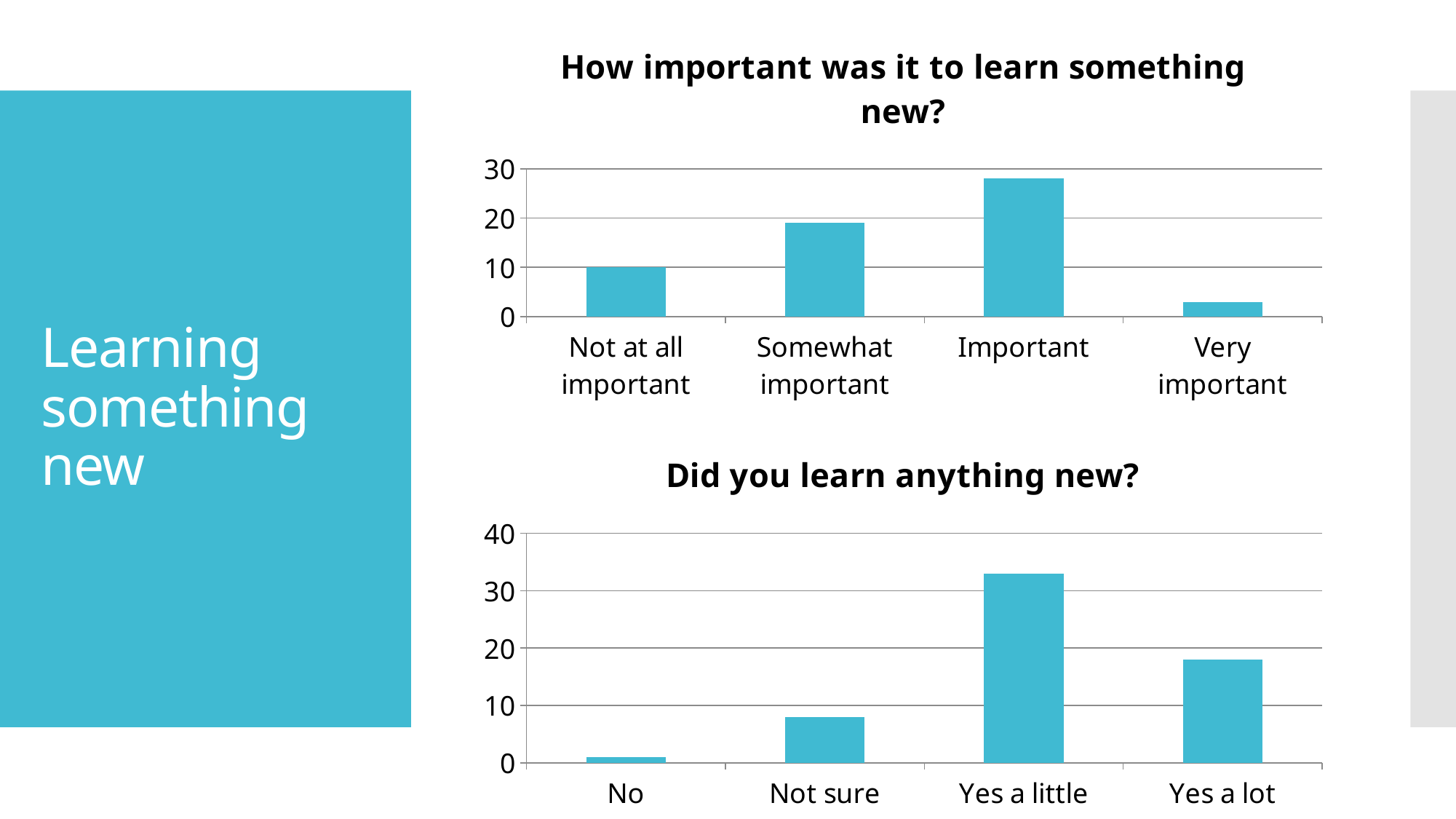
In the chart titled "How important was it to learn something new?", is the value for Important greater or less than 20? greater What is the title of the top chart on the slide? How important was it to learn something new? In the chart titled "How important was it to learn something new?", which category has the lowest value? Very important In the chart titled "How important was it to learn something new?", which category has the highest value? Important In the chart titled "How important was it to learn something new?", is the value for Somewhat important greater or less than 10? greater In the chart titled "How important was it to learn something new?", how many categories are shown on the x axis? 4 In the chart titled "Did you learn anything new?", which category has the highest value? Yes a little What kind of chart is the chart titled "Did you learn anything new?"? bar chart In the chart titled "Did you learn anything new?", which category has the lowest value? No In the chart titled "Did you learn anything new?", is the value for Yes a lot greater or less than 20? less In the chart titled "Did you learn anything new?", which is larger, the value for Yes a little or the value for Yes a lot? Yes a little